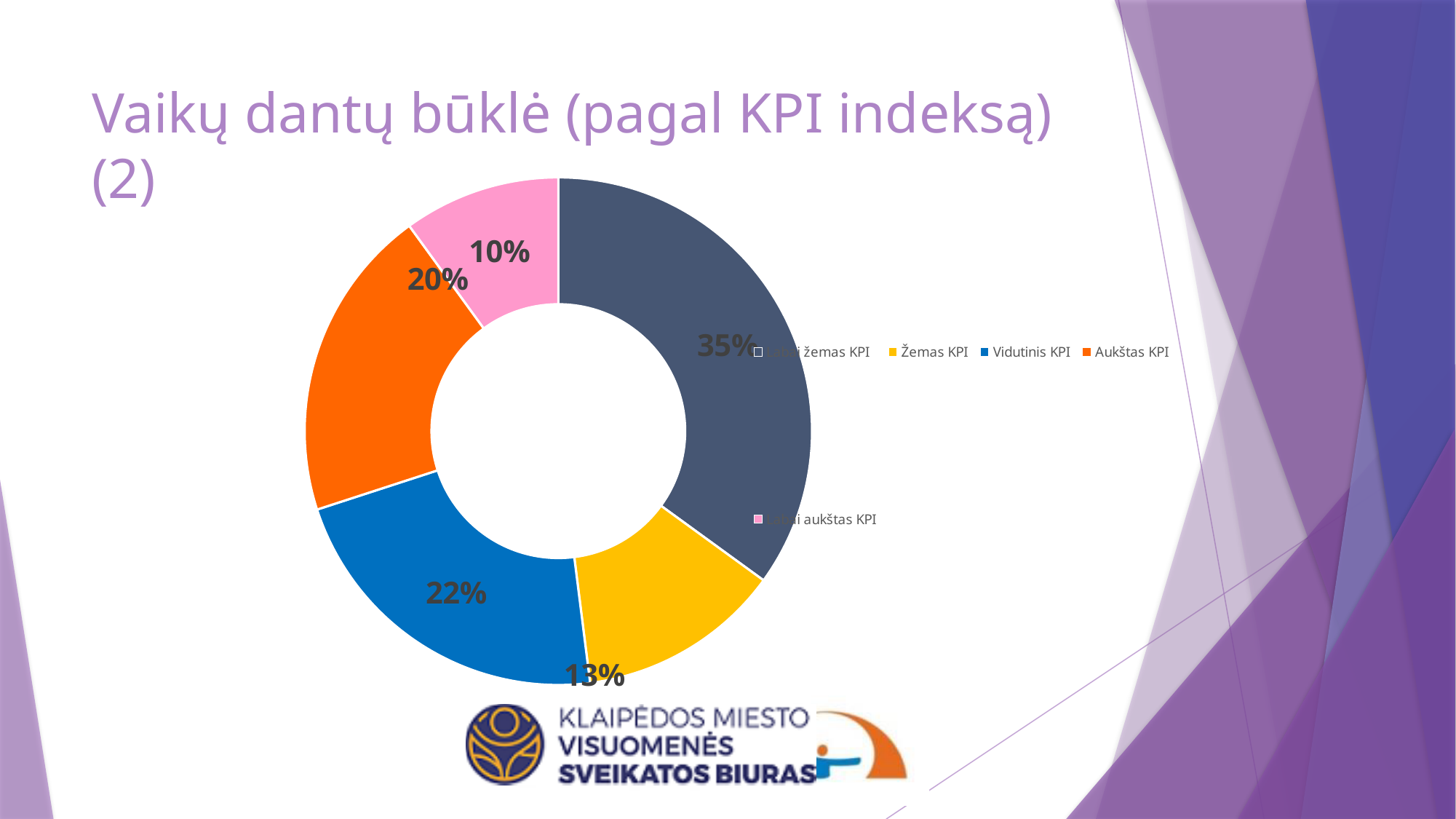
What colour is the Vidutinis KPI slice? Blue What colour is the Aukštas KPI slice? Orange What is the value for Žemas KPI? 13% What kind of chart is shown on the slide? Doughnut chart Which is larger, Vidutinis KPI or Aukštas KPI? Vidutinis KPI What is the value for Vidutinis KPI? 22% What is the value shown on the smallest slice of the chart? 10% What is the value shown on the largest slice of the chart? 35% What is the value for Aukštas KPI? 20% What is the difference between the values for Vidutinis KPI and Žemas KPI? 9% How many slices does the chart have? 5 What is the difference between the values for Aukštas KPI and Žemas KPI? 7%